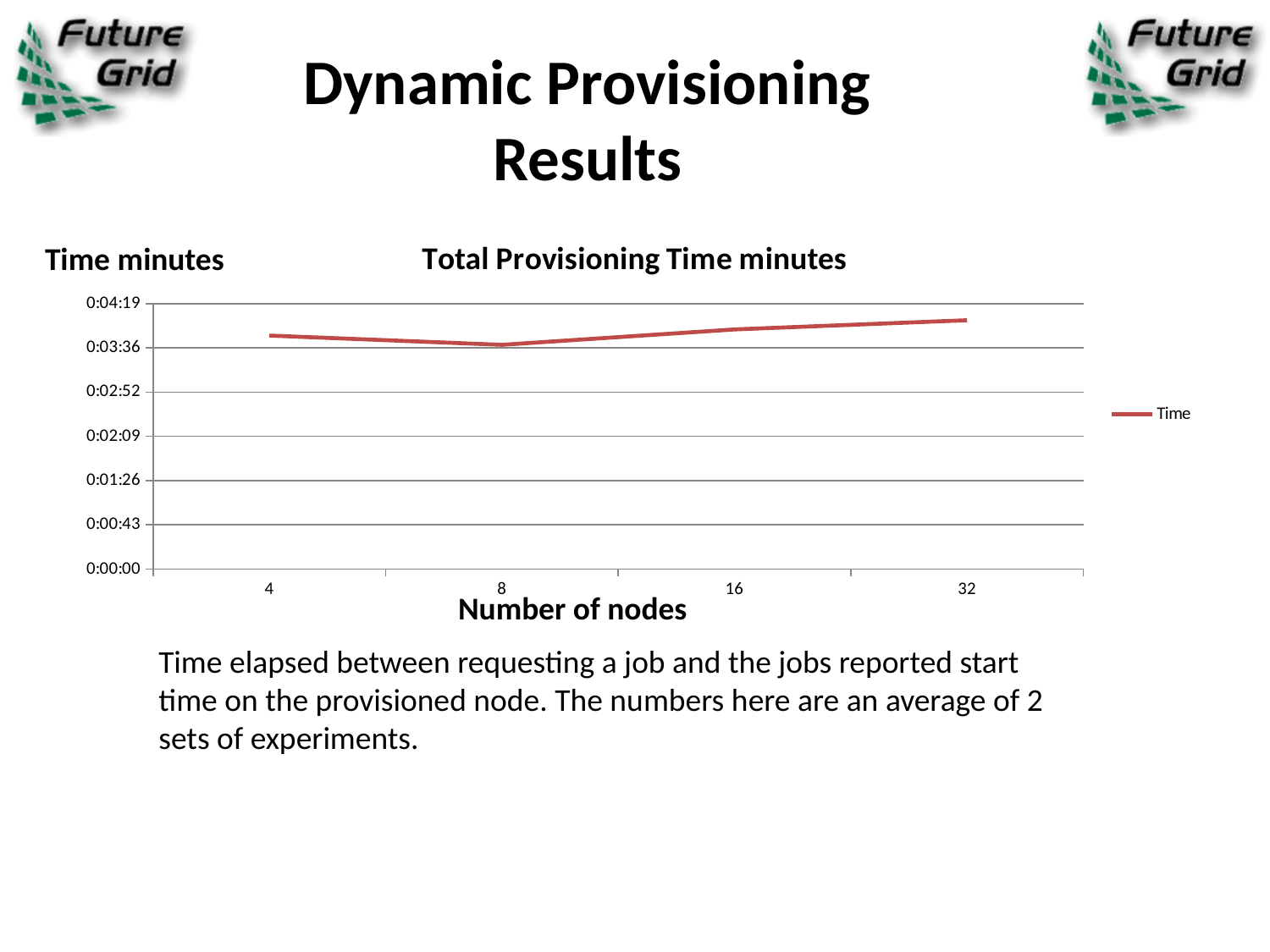
At which number of nodes is the provisioning time lowest? 8 Is the provisioning time for 16 nodes greater or less than 0:04:19? less What kind of chart is shown on the slide? line chart How many node counts are plotted along the x axis? 4 Which has a larger provisioning time, 8 nodes or 32 nodes? 32 nodes Is the provisioning time for 4 nodes greater or less than 0:02:52? greater What is the name of the series in the legend? Time Is the provisioning time for 32 nodes greater or less than 0:03:36? greater Does the provisioning time rise or fall from 8 nodes to 32 nodes? rise At which number of nodes is the provisioning time highest? 32 What is the title of the chart? Total Provisioning Time minutes How many series does the legend list? 1